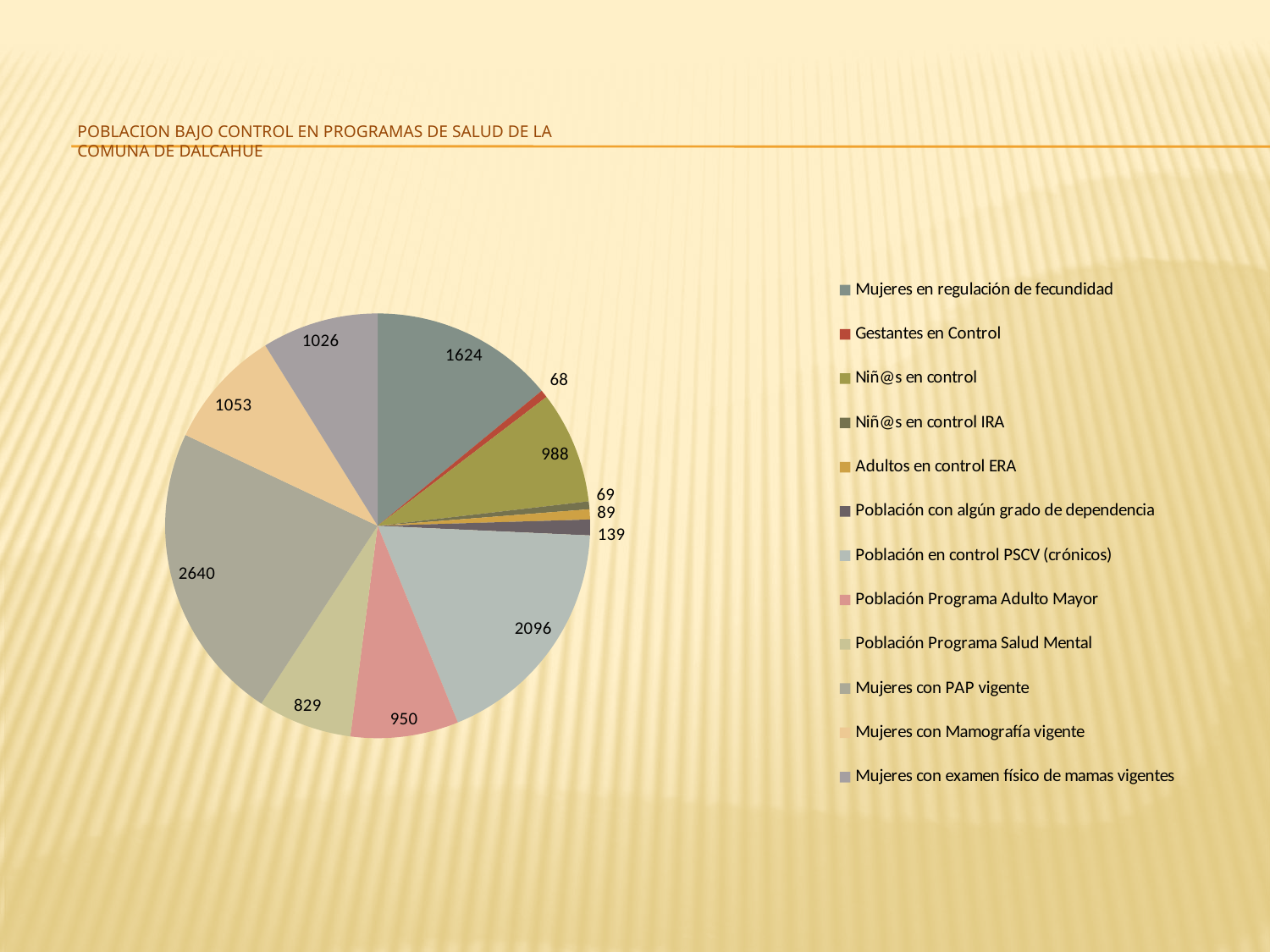
Which is larger, Mujeres en regulación de fecundidad or Niñ@s en control? Mujeres en regulación de fecundidad What is the difference between Mujeres con PAP vigente and Población en control PSCV (crónicos)? 544 How many slices does the pie chart have? 12 What type of chart is shown on the slide? pie chart What is the value for Población en control PSCV (crónicos)? 2096 What is the title of the slide? POBLACION BAJO CONTROL EN PROGRAMAS DE SALUD DE LA COMUNA DE DALCAHUE What is the value for Mujeres con PAP vigente? 2640 How many entries does the legend list? 12 Which category has the smallest value? Gestantes en Control What is the value for Población Programa Adulto Mayor? 950 What is the value for Mujeres con Mamografía vigente? 1053 Which category has the largest slice? Mujeres con PAP vigente